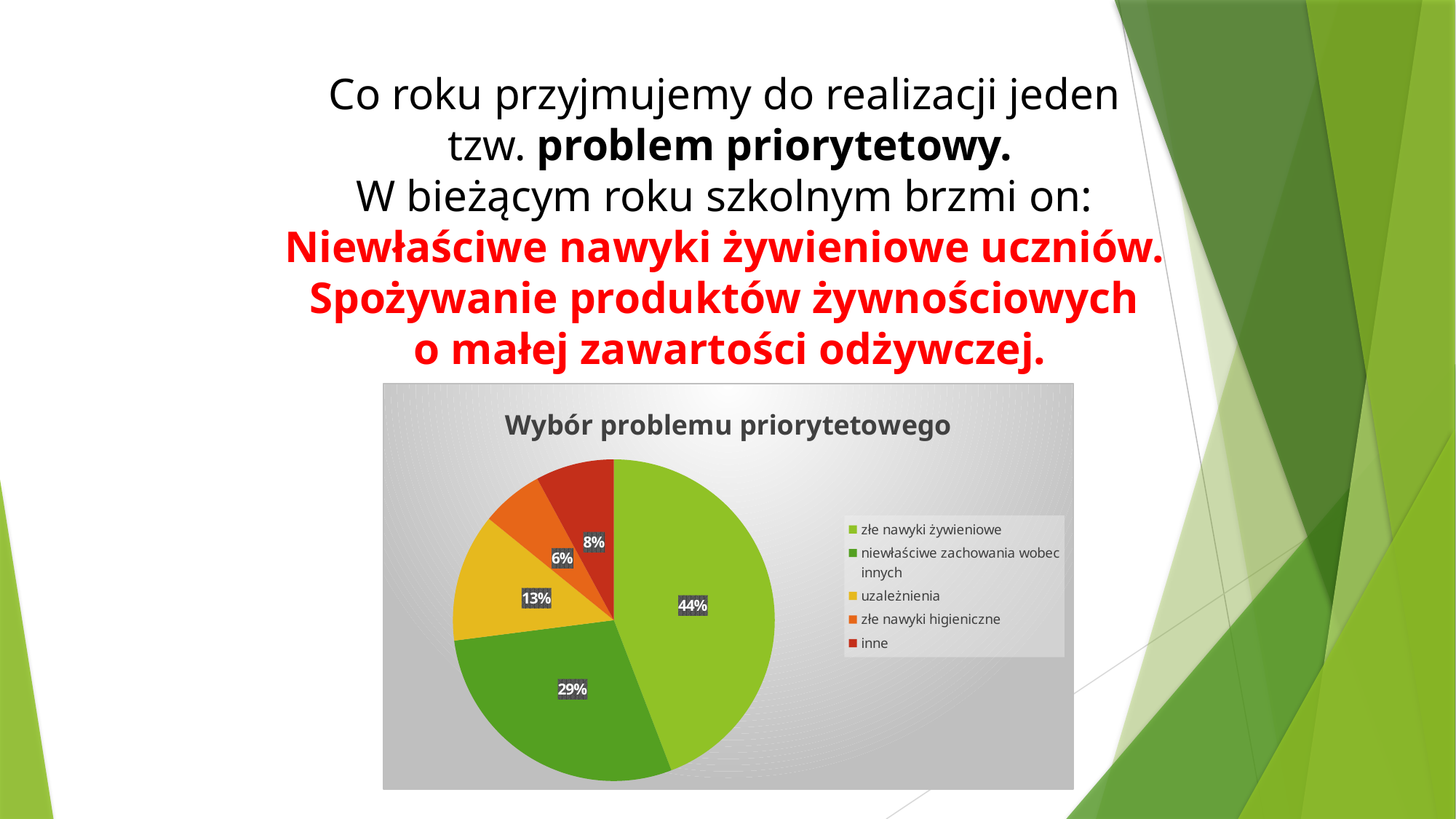
What share of the pie is 'niewłaściwe zachowania wobec innych'? 29% Which is larger, the share for 'inne' or the share for 'złe nawyki higieniczne'? inne What is the difference between the shares of 'złe nawyki żywieniowe' and 'niewłaściwe zachowania wobec innych'? 15% What share of the pie is 'złe nawyki higieniczne'? 6% What share of the pie is 'uzależnienia'? 13% How many slices does the pie chart have? 5 What kind of chart is shown on the slide? Pie chart Which category has the largest share of the pie? złe nawyki żywieniowe Which category has the smallest share of the pie? złe nawyki higieniczne What is the title of the chart? Wybór problemu priorytetowego